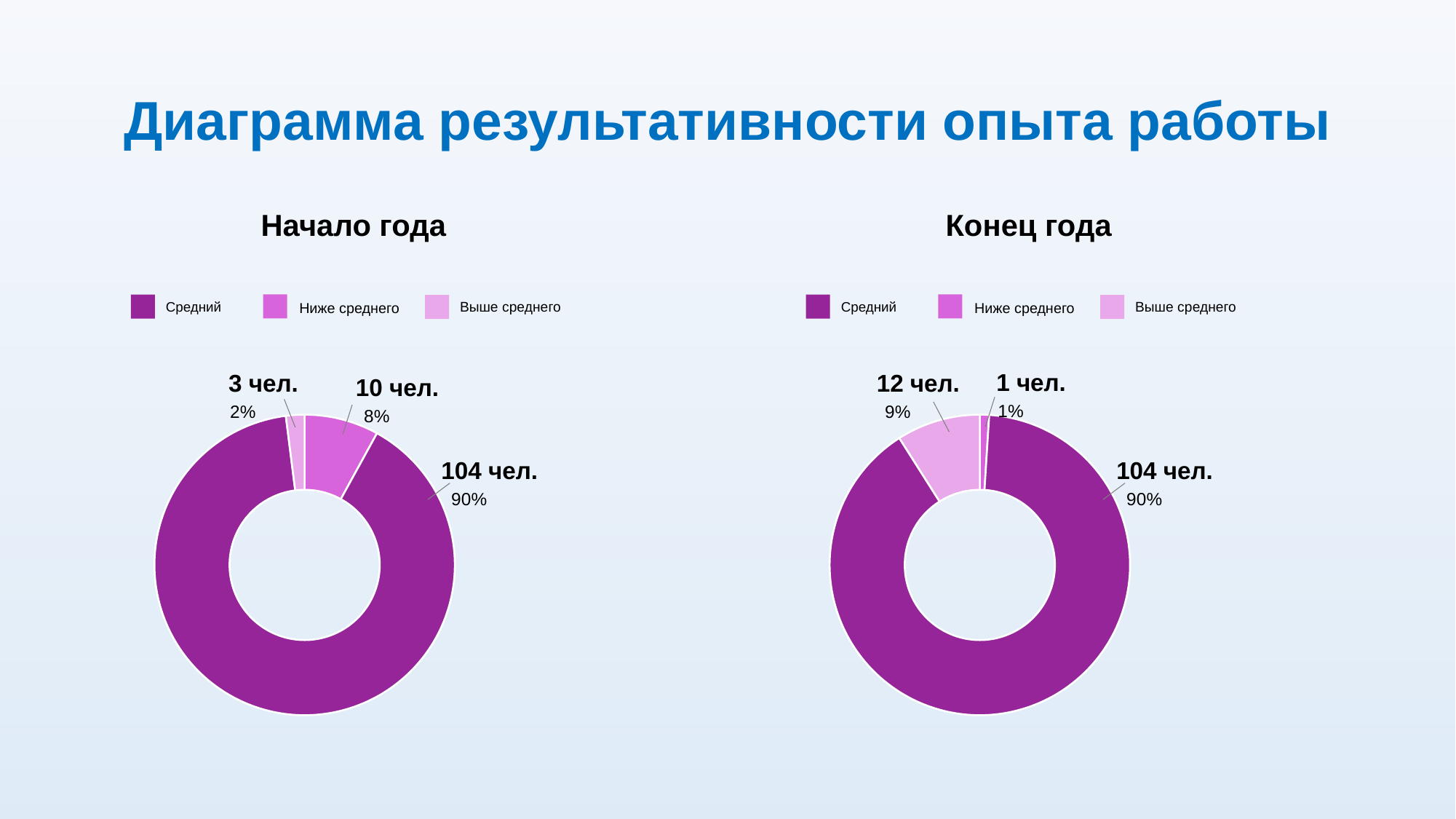
In the "Конец года" chart, which category has the largest share? Средний What is the title of the slide? Диаграмма результативности опыта работы What is the difference in the number of people in "Выше среднего" between the "Конец года" chart and the "Начало года" chart? 9 чел. In the "Начало года" chart, how many people are in the "Средний" category? 104 чел. In the "Начало года" chart, what percentage share does "Ниже среднего" have? 8% Which is larger: "Ниже среднего" in the "Начало года" chart or "Ниже среднего" in the "Конец года" chart? Начало года What type of chart is the "Начало года" chart? Doughnut chart In the "Начало года" chart, which category has the smallest share? Выше среднего In the "Начало года" chart, how many people are in the "Выше среднего" category? 3 чел. In the "Конец года" chart, what percentage share does "Ниже среднего" have? 1% In the "Конец года" chart, how many people are in the "Выше среднего" category? 12 чел. How many categories does the legend of the "Конец года" chart list? 3